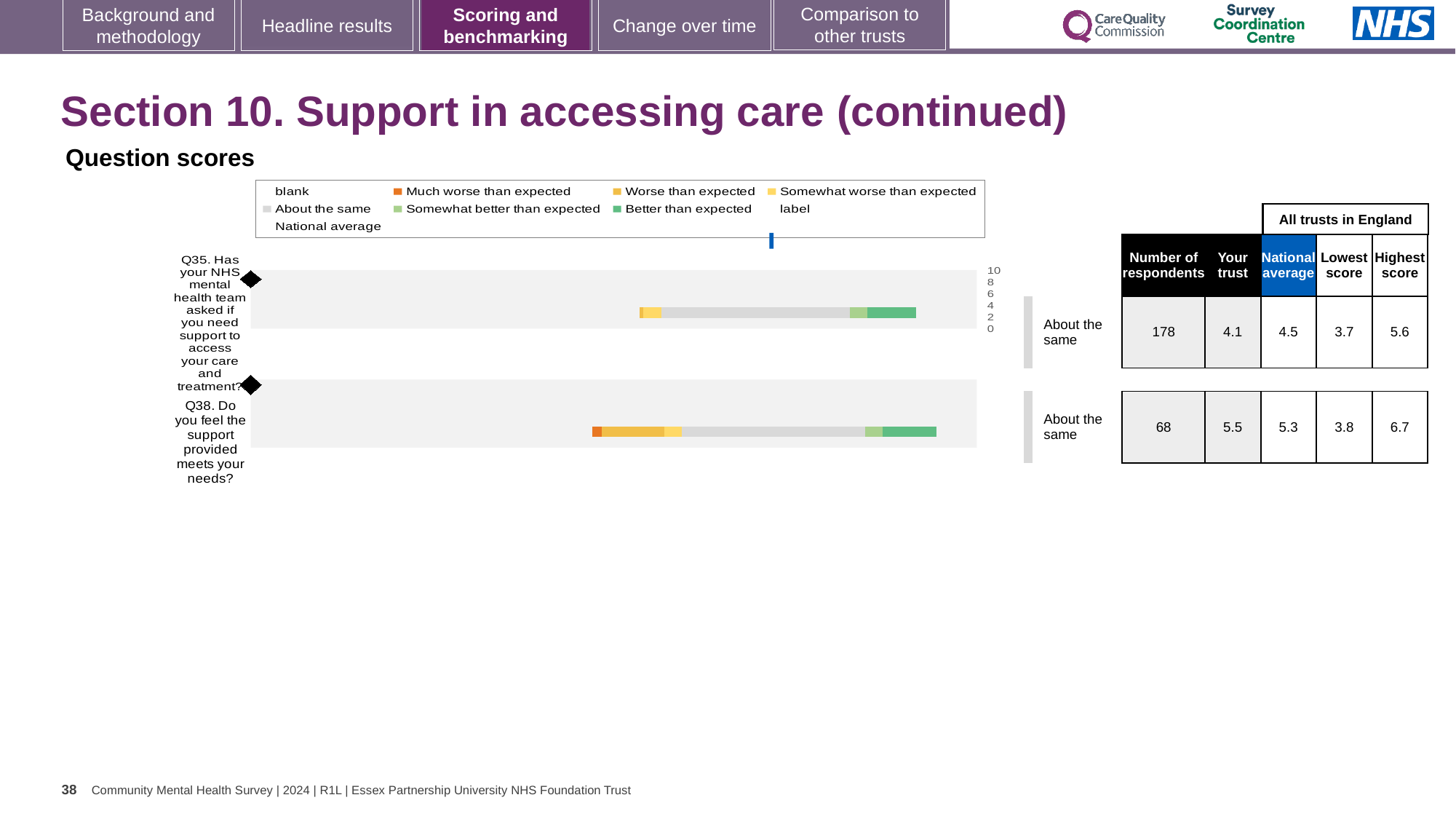
How many questions are plotted in the question scores chart? 2 Which legend entry in the question scores chart is shown in orange? Much worse than expected What is the highest score across all trusts in England for Q35? 5.6 Which question has the higher 'Your trust' score, Q35 or Q38? Q38 How many respondents answered Q38 according to the question scores chart? 68 What is the national average score for Q35 in the question scores chart? 4.5 By how much does the national average for Q35 exceed the trust's own score for Q35? 0.4 What is the difference between the highest score and the lowest score for Q38? 2.9 What kind of chart is used to show the question scores on this slide? bar chart What benchmark category is shown for Q35 in the question scores chart? About the same In the question scores chart, what is the 'Your trust' score for Q38? 5.5 In the question scores chart, what is the 'Your trust' score for Q35? 4.1